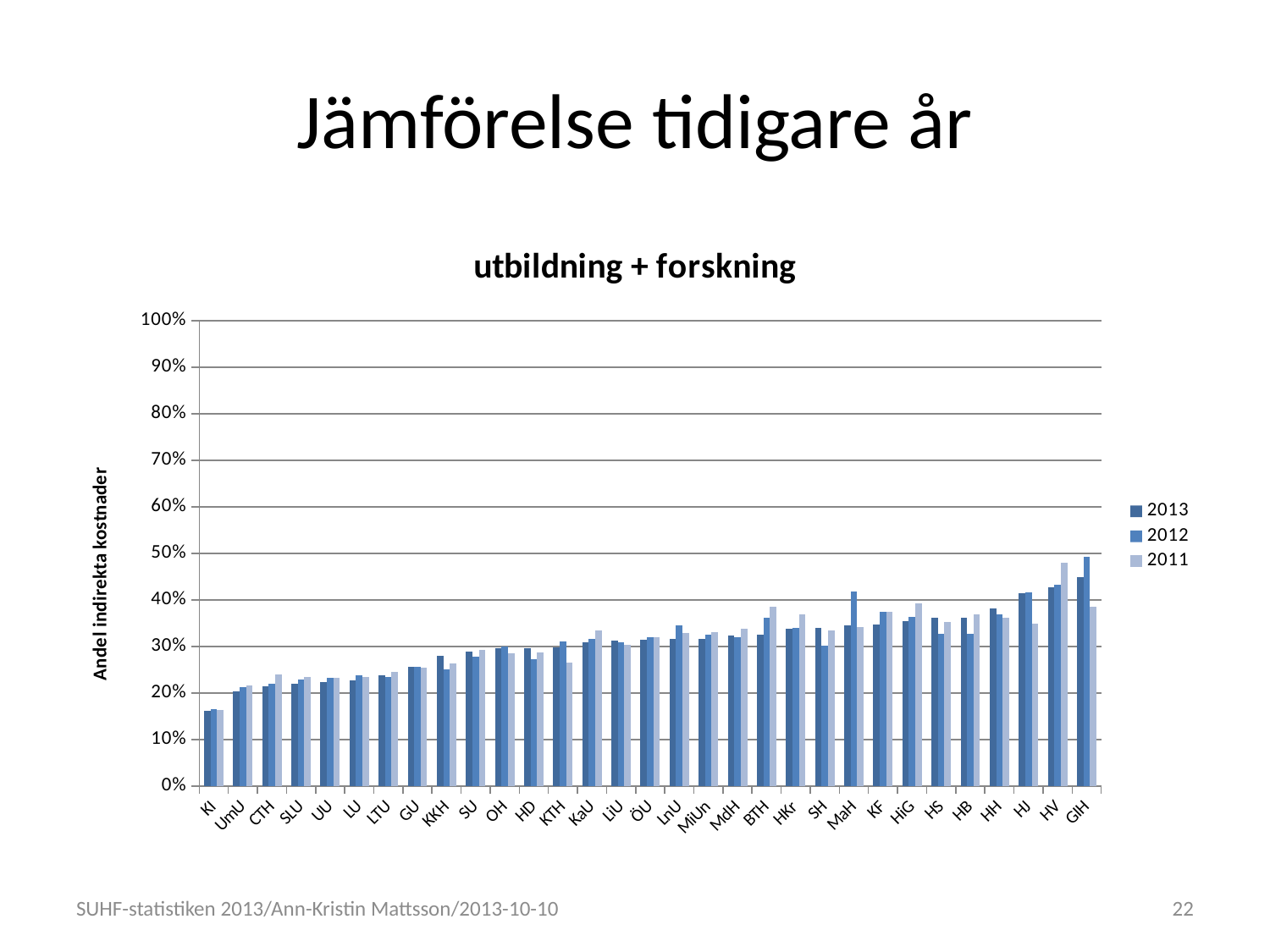
Which category has the lowest value for 2013? KI How many series does the legend list? 3 How many categories are shown along the x axis? 31 Is the value for GIH in 2012 greater or less than 40%? greater Is the value for MaH in 2012 greater or less than 40%? greater Is the value for KI in 2013 greater or less than 20%? less Which category has the highest value for 2012? GIH What is the label on the vertical axis? Andel indirekta kostnader For MaH, which is larger: the 2012 value or the 2013 value? 2012 Do the 2013 values generally rise or fall moving from left to right along the x axis? rise What is the title of the chart? utbildning + forskning What kind of chart is shown on the slide? bar chart